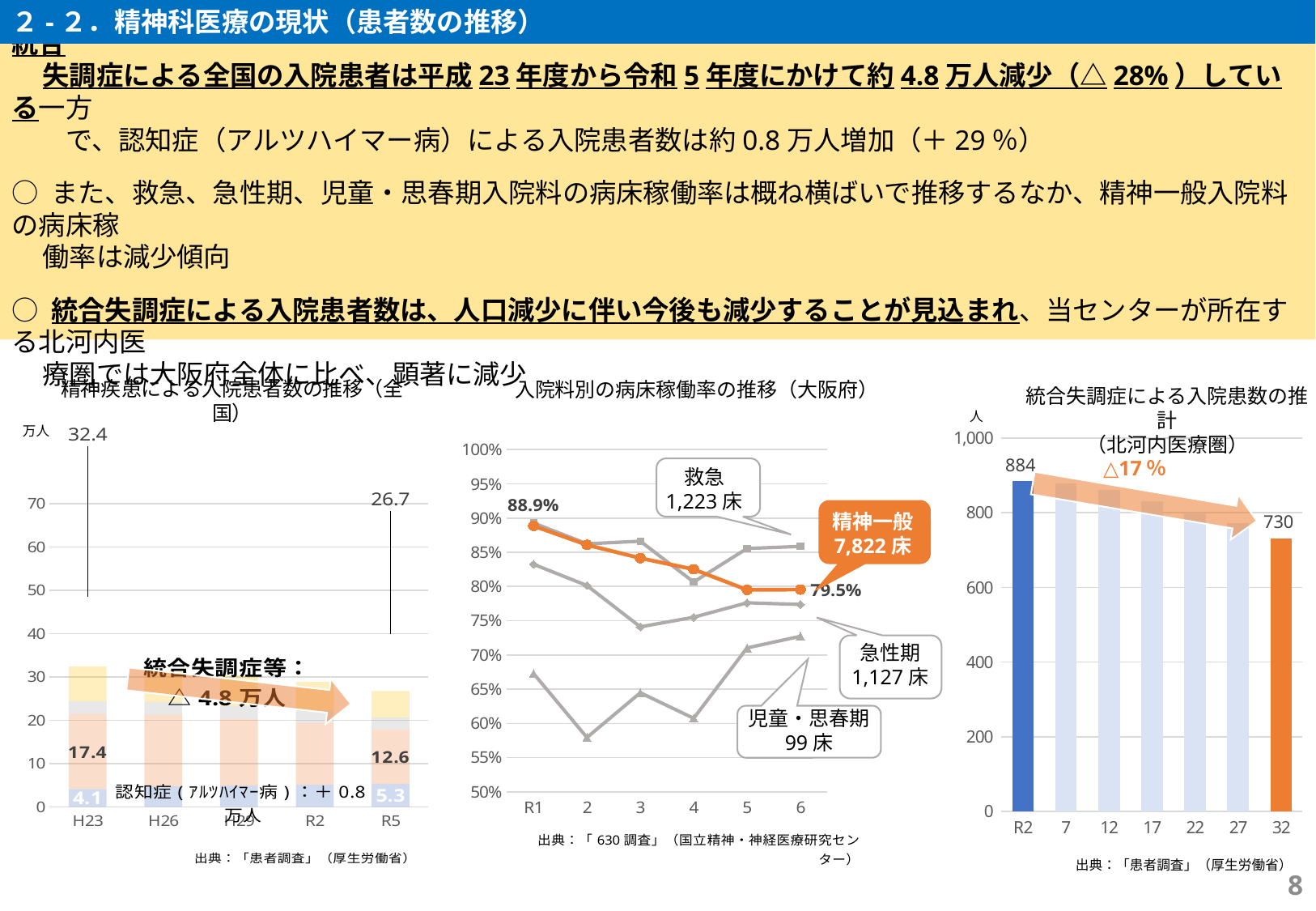
In the left chart (精神疾患による入院患者数の推移（全国）), what is the total number of inpatients shown for H23? 32.4 In the left chart (精神疾患による入院患者数の推移（全国）), what is the value labelled on the 統合失調症等 segment for R5? 12.6 What kind of chart is the middle chart (入院料別の病床稼働率の推移（大阪府）)? line chart In the left chart (精神疾患による入院患者数の推移（全国）), how many years are shown on the x axis? 5 In the left chart (精神疾患による入院患者数の推移（全国）), what is the total number of inpatients shown for R5? 26.7 In the middle chart (入院料別の病床稼働率の推移（大阪府）), does the 精神一般 line rise or fall from R1 to 6? fall In the middle chart (入院料別の病床稼働率の推移（大阪府）), what is the 精神一般 occupancy rate at year 6? 79.5% In the right chart (統合失調症による入院患数の推計（北河内医療圏）), what is the value for R2? 884 In the middle chart (入院料別の病床稼働率の推移（大阪府）), what is the 精神一般 occupancy rate at R1? 88.9% In the right chart (統合失調症による入院患数の推計（北河内医療圏）), what is the difference between the R2 value (884) and the value for 32 (730)? 154 In the left chart (精神疾患による入院患者数の推移（全国）), by how much did the 統合失調症等 value fall from H23 (17.4) to R5 (12.6)? 4.8 In the right chart (統合失調症による入院患数の推計（北河内医療圏）), which year has the highest value? R2